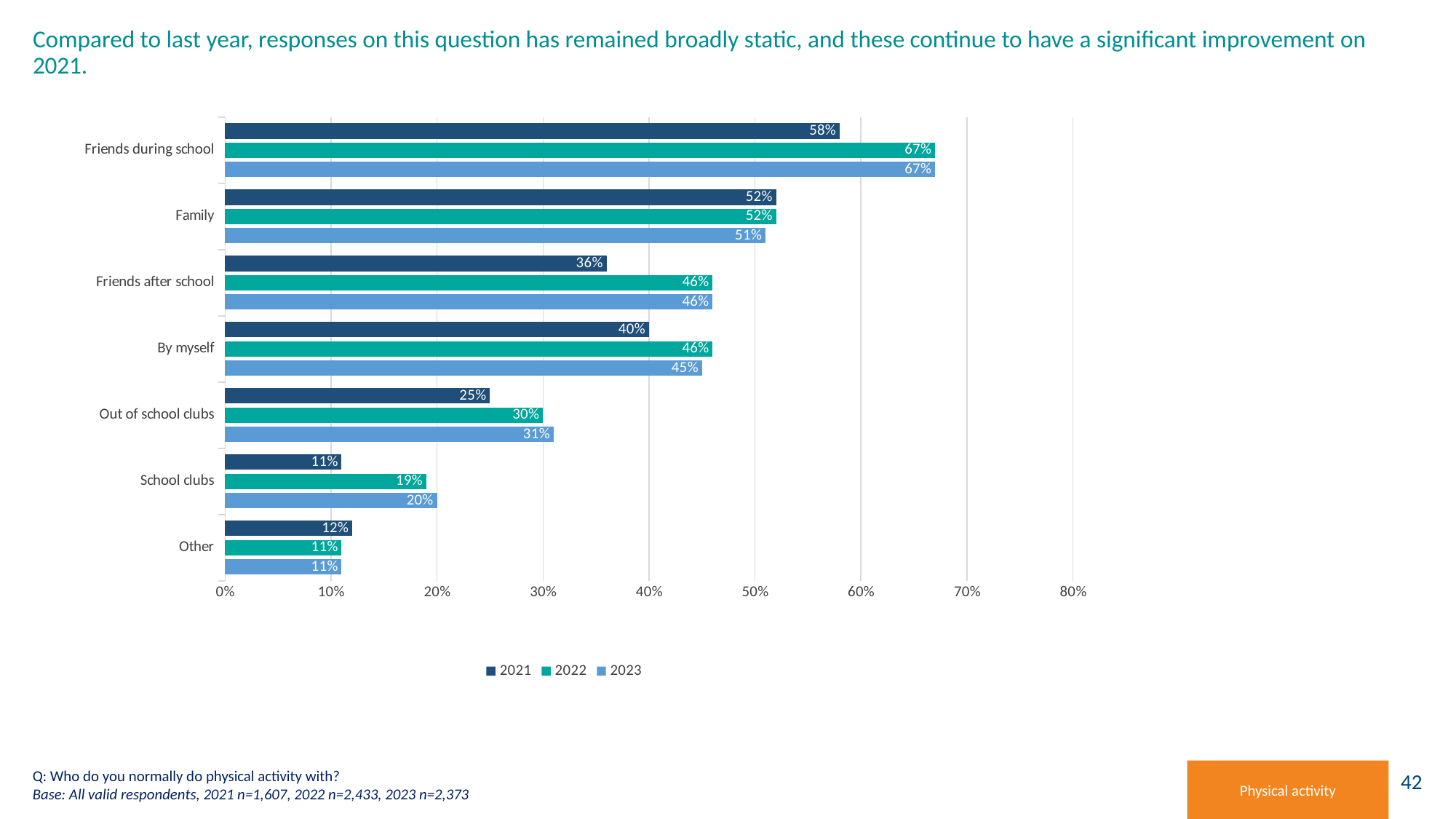
Which category has the highest 2023 value? Friends during school Which series does the legend list first? 2021 What is the 2021 value for Friends after school? 36% Which is larger: the 2021 value for By myself or the 2021 value for Friends after school? By myself What is the difference between the 2023 and 2021 values for Out of school clubs? 6% Which category has the lowest 2021 value? School clubs How many series does the legend list? 3 What is the difference between the 2022 and 2021 values for Friends after school? 10% What kind of chart is shown on the slide? Bar chart What is the 2022 value for School clubs? 19% What is the 2023 value for Friends during school? 67% How many categories are shown on the chart? 7